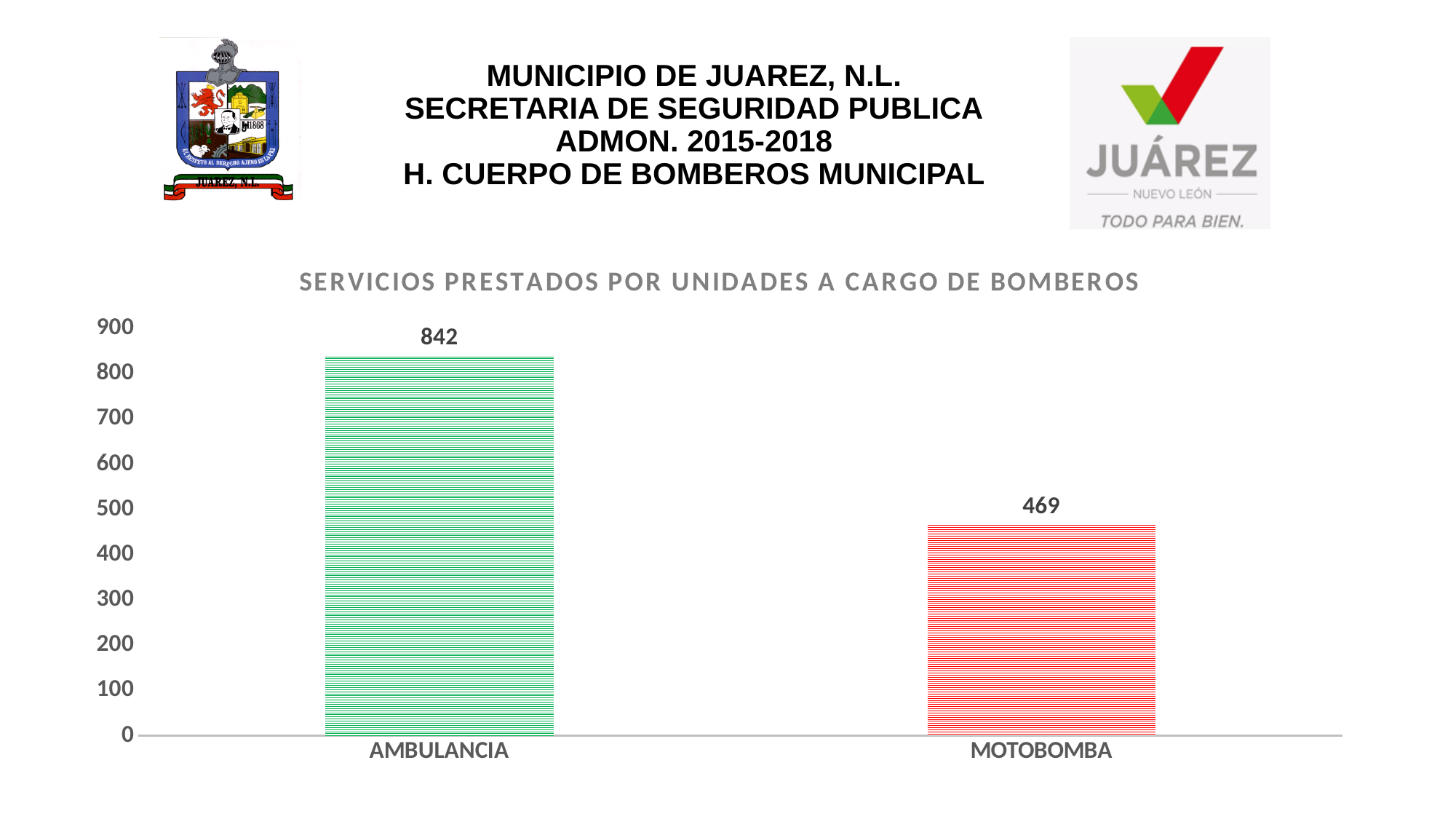
What is the value for MOTOBOMBA? 469 Which category has the lowest value? MOTOBOMBA How many categories are shown on the chart? 2 Is the value for MOTOBOMBA greater or less than 500? less Which category has the highest value? AMBULANCIA Which is larger, the value for AMBULANCIA or the value for MOTOBOMBA? AMBULANCIA Is the value for AMBULANCIA greater or less than 800? greater What is the difference between the values for AMBULANCIA and MOTOBOMBA? 373 What is the value for AMBULANCIA? 842 What colour is the bar for MOTOBOMBA? red What kind of chart is shown on the slide? bar chart What is the title of the chart? SERVICIOS PRESTADOS POR UNIDADES A CARGO DE BOMBEROS